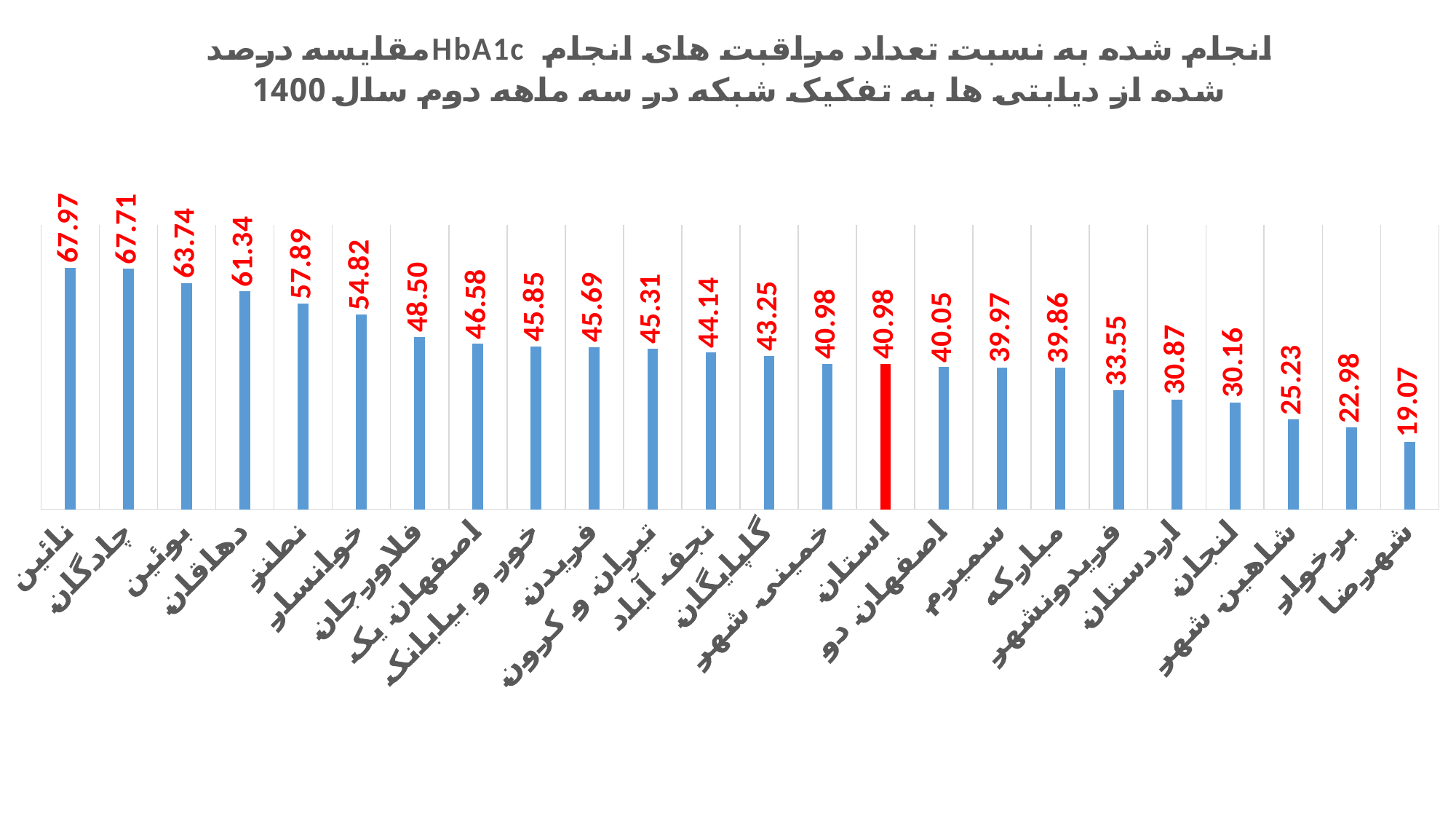
What is the value for نائین? 67.97 Which category has the highest value? نائین What is the difference between the values for نائین and شهرضا? 48.90 What is the difference between the values for چادگان and بوئین? 3.97 Which category has the lowest value? شهرضا Which is larger, the value for نطنز or the value for خوانسار? نطنز How many categories are shown on the x axis? 24 What kind of chart is shown on the slide? bar chart Do the values rise or fall from left to right along the x axis? fall What is the value for فلاورجان? 48.50 What is the value for شهرضا? 19.07 What is the value for استان (the red bar)? 40.98